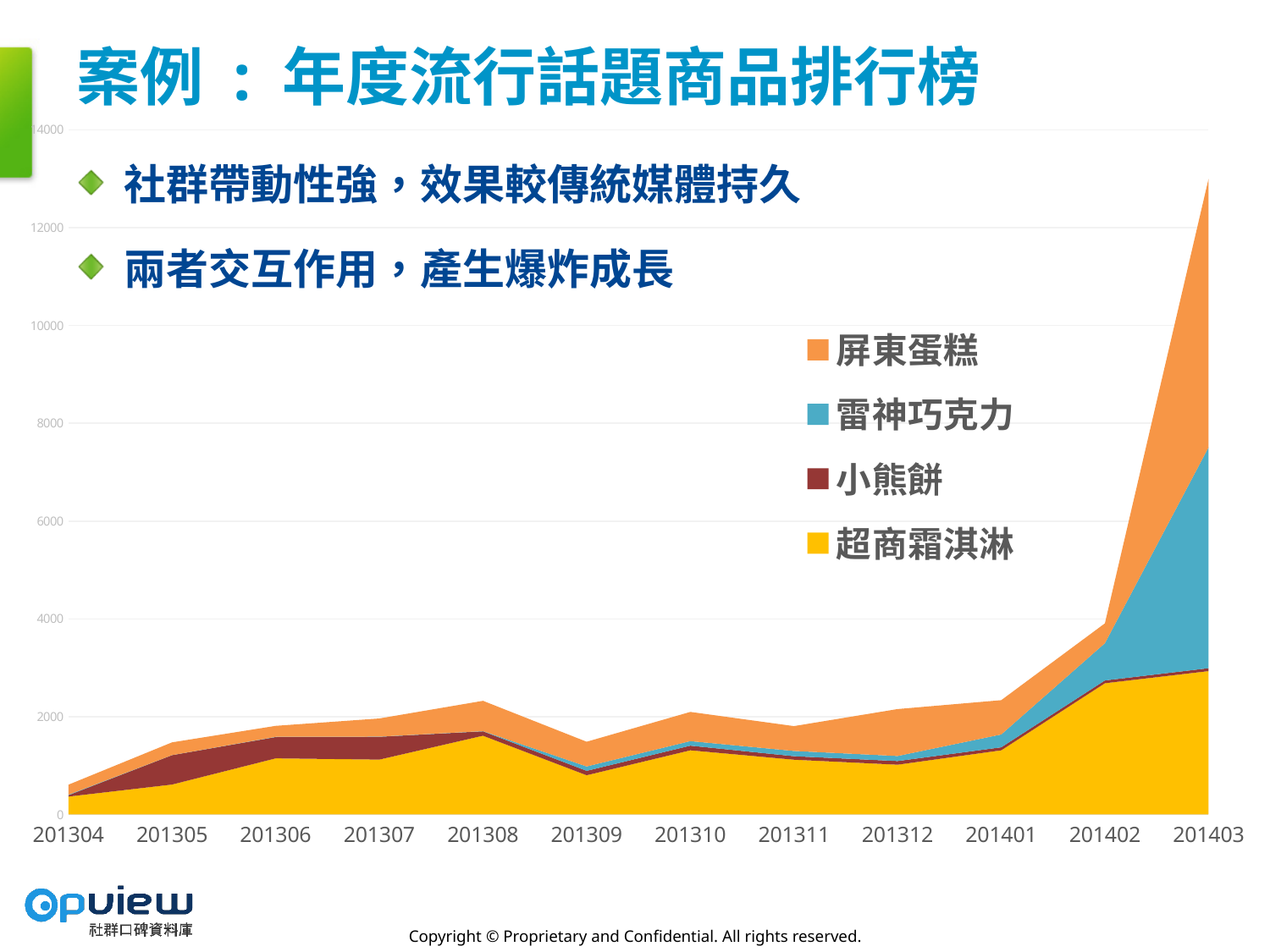
Is the stacked total for 201304 greater or less than 2000? less Which colour represents 超商霜淇淋 in the chart? Yellow How many series does the chart's legend list? 4 Which period has a larger stacked total, 201402 or 201403? 201403 Is the stacked total for 201309 greater or less than 2000? less What kind of chart is shown on the slide? Stacked area chart In which period is the stacked total lowest? 201304 Does the stacked total generally rise or fall from 201304 to 201403? Rise Is the stacked total for 201403 greater or less than 12000? greater How many time periods are shown along the x axis of the chart? 12 In which period is the stacked total highest? 201403 Which series are listed in the chart's legend? 屏東蛋糕, 雷神巧克力, 小熊餅, 超商霜淇淋